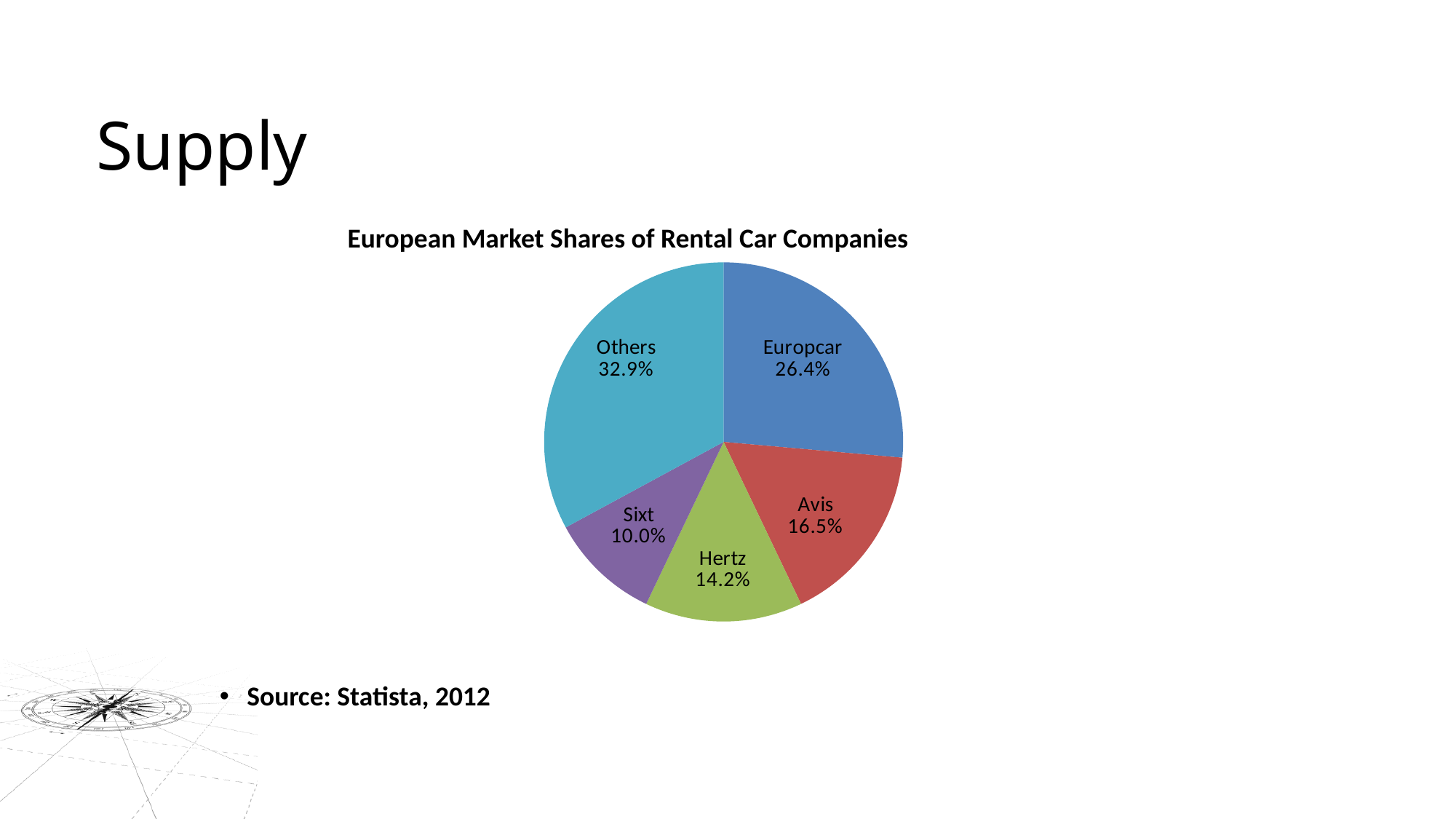
How many slices does the pie chart have? 5 What type of chart is shown on the slide? pie chart What market share does Avis hold? 16.5% Which named rental car company has the smallest market share? Sixt What is the title of the chart? European Market Shares of Rental Car Companies What market share does Hertz hold? 14.2% What is the combined market share of Europcar and Avis? 42.9% Which has a larger market share, Hertz or Sixt? Hertz What is the difference in market share between Europcar and Avis? 9.9% What market share does Europcar hold? 26.4% What market share does Sixt hold? 10.0% Which slice of the pie is the largest? Others